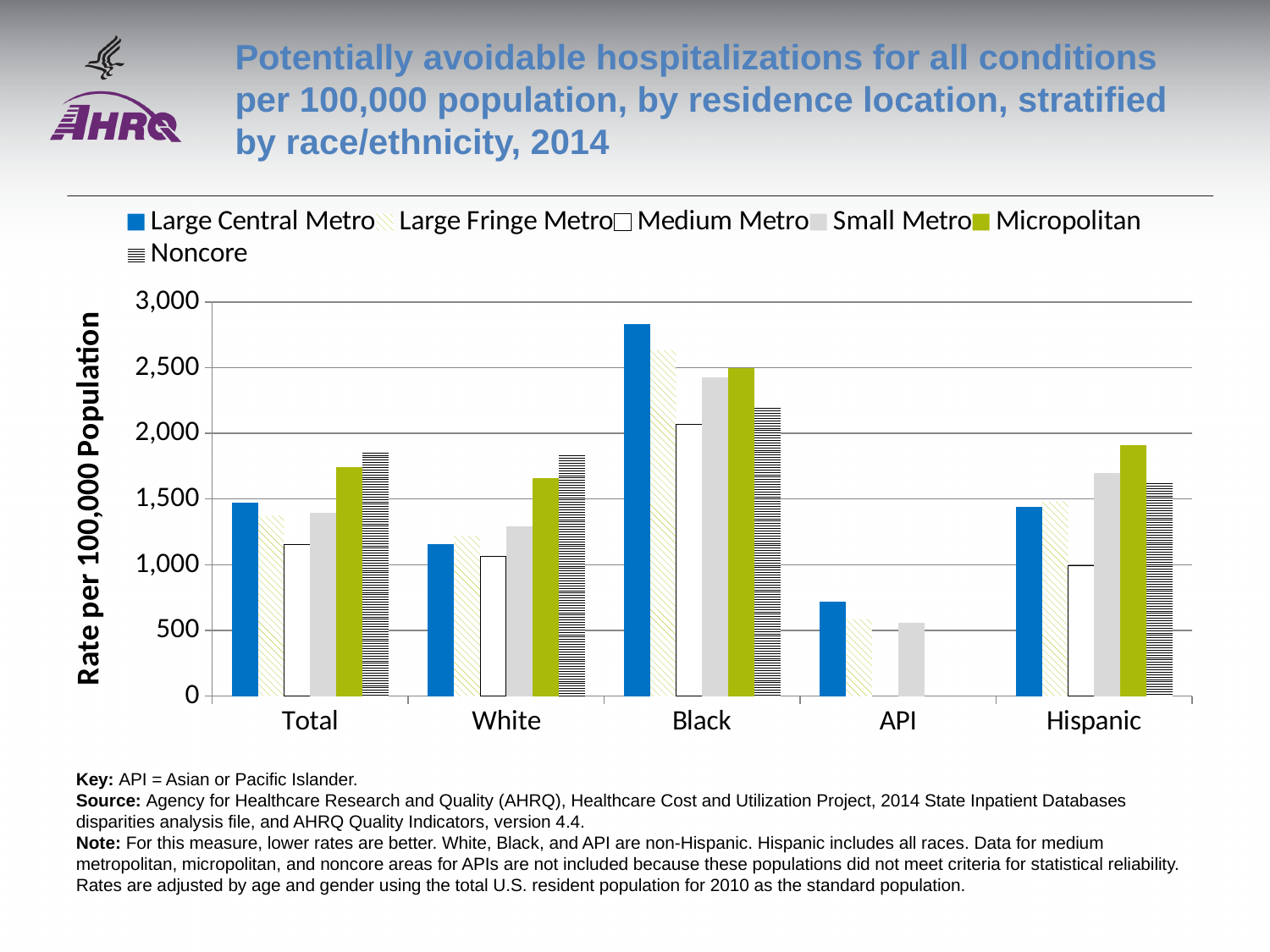
Is the Medium Metro value for White greater or less than 1,500? less How many race/ethnicity categories are shown on the x axis? 5 Which race/ethnicity category has the lowest Large Central Metro bar? API Is the Micropolitan value for Hispanic greater or less than 1,500? greater Which race/ethnicity category has the highest Large Central Metro bar? Black For Black, which is larger: the Medium Metro value or the Small Metro value? Small Metro What kind of chart is shown on the slide? Bar chart For Total, which is larger: the Noncore value or the Medium Metro value? Noncore How many series does the legend list? 6 Is the Large Central Metro value for Black greater or less than 2,500? greater What is the title of the y axis? Rate per 100,000 Population